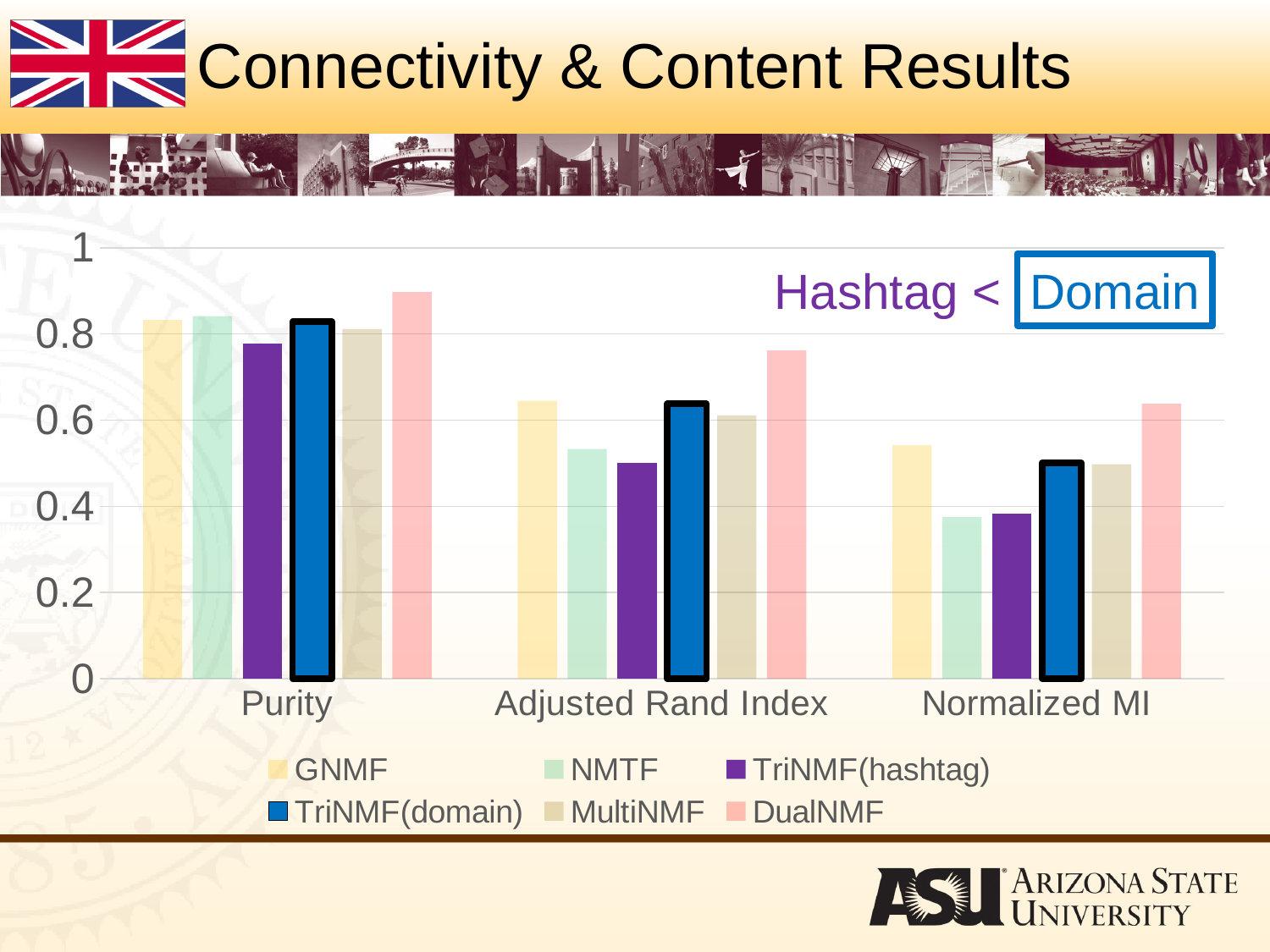
Which series has the lowest value for Purity? TriNMF(hashtag) How many series does the chart's legend list? 6 Is the value for NMTF in Normalized MI greater or less than 0.4? less How many categories are shown on the x axis of the chart? 3 Which series has the highest value for Adjusted Rand Index? DualNMF Is the value for DualNMF in Purity greater or less than 0.8? greater What annotation text is written in the upper right of the chart area? Hashtag < Domain Do the DualNMF values rise or fall from Purity to Normalized MI along the x axis? fall Which series has the highest value for Purity? DualNMF Is the value for TriNMF(hashtag) in Purity greater or less than 0.8? less For Normalized MI, which is larger: TriNMF(domain) or TriNMF(hashtag)? TriNMF(domain) What kind of chart is shown on the slide? bar chart